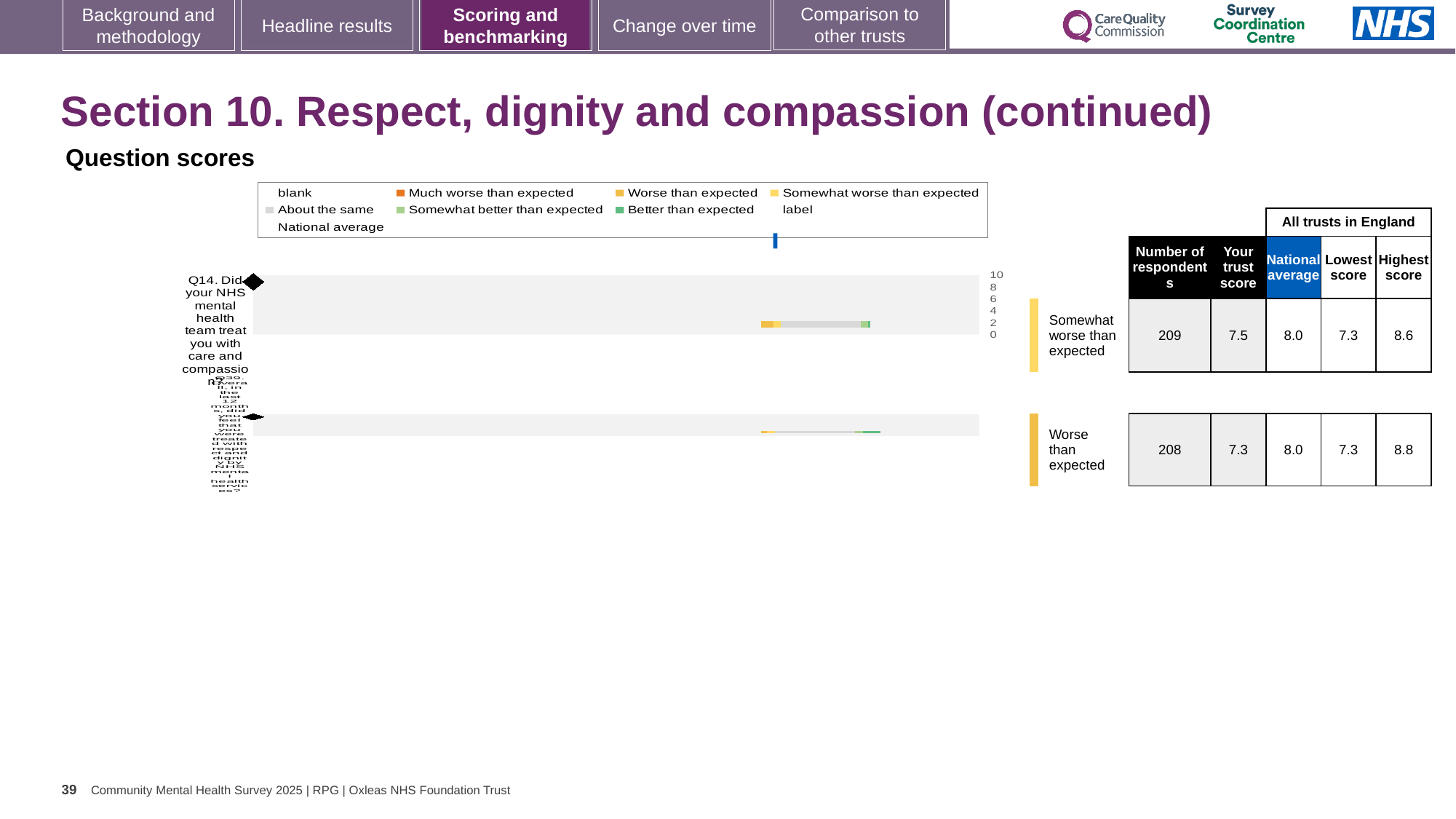
What is the lowest score among all trusts in England for Q14? 7.3 Which question has the higher trust score, Q14 or the second (lower) question? Q14 What is the trust score for the second (lower) question row on the chart? 7.3 What is the trust score for Q14 (Did your NHS mental health team treat you with care and compassion?)? 7.5 What is the national average score for Q14? 8.0 What is the highest score among all trusts in England for the second (lower) question? 8.8 How many respondents answered Q14? 209 What is the highest score among all trusts in England for Q14? 8.6 By how much is the trust score for Q14 below the national average? 0.5 What benchmark category is shown for Q14? Somewhat worse than expected How many respondents answered the second (lower) question on the chart? 208 How many questions are plotted on the chart? 2